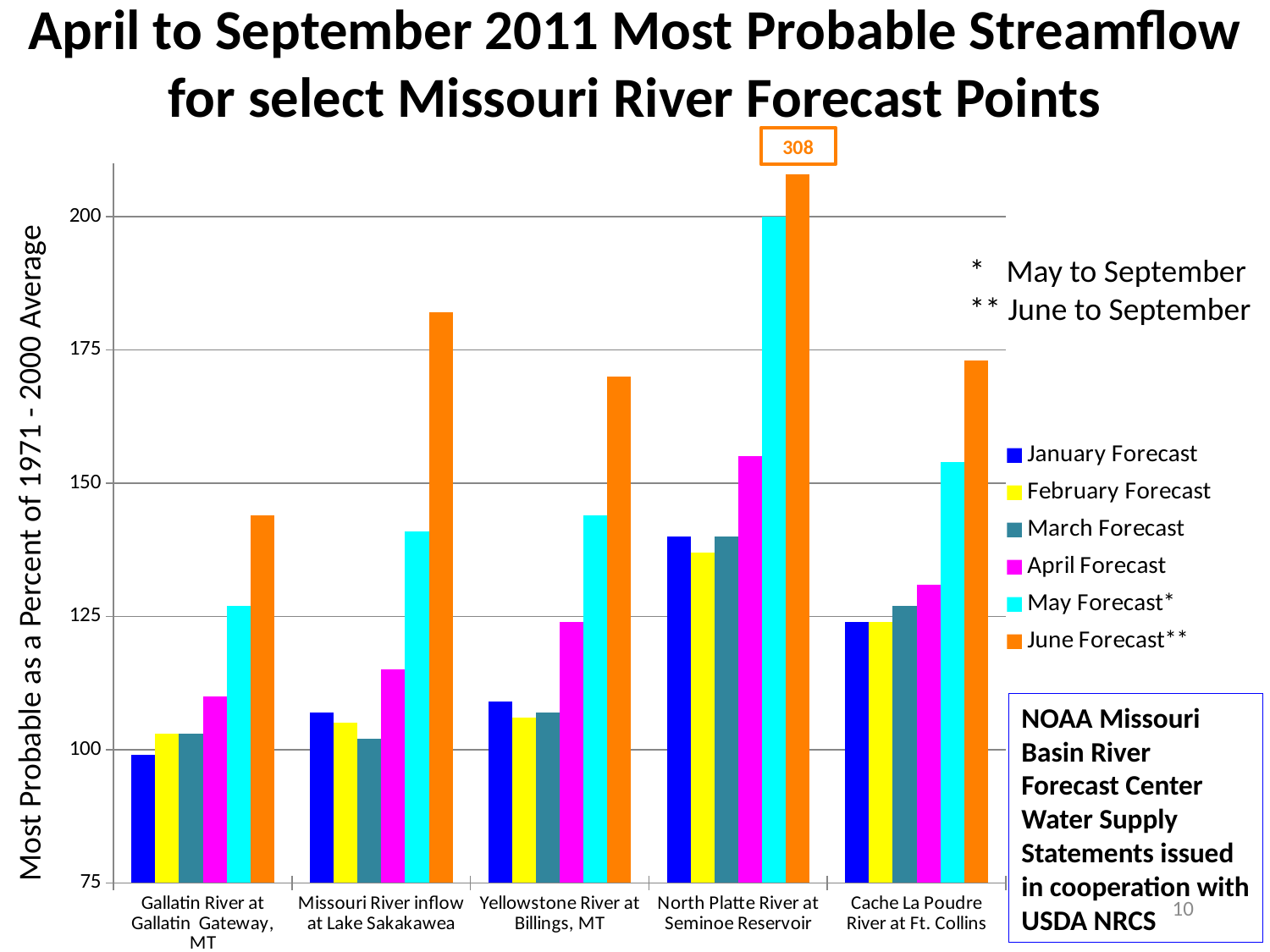
Which forecast point has the lowest January Forecast value? Gallatin River at Gallatin Gateway, MT Which is larger, the June Forecast for Missouri River inflow at Lake Sakakawea or the June Forecast for Yellowstone River at Billings, MT? Missouri River inflow at Lake Sakakawea What is the June Forecast value for the North Platte River at Seminoe Reservoir? 308 Is the May Forecast value for Cache La Poudre River at Ft. Collins greater or less than 150? greater Is the June Forecast value for Missouri River inflow at Lake Sakakawea greater or less than 175? greater How many forecast points (categories) are shown on the x axis? 5 What is the title of the vertical axis? Most Probable as a Percent of 1971 - 2000 Average How many series does the legend list? 6 What kind of chart is shown on the slide? bar chart Is the June Forecast value for Gallatin River at Gallatin Gateway, MT greater or less than 150? less Which forecast point has the highest June Forecast value? North Platte River at Seminoe Reservoir